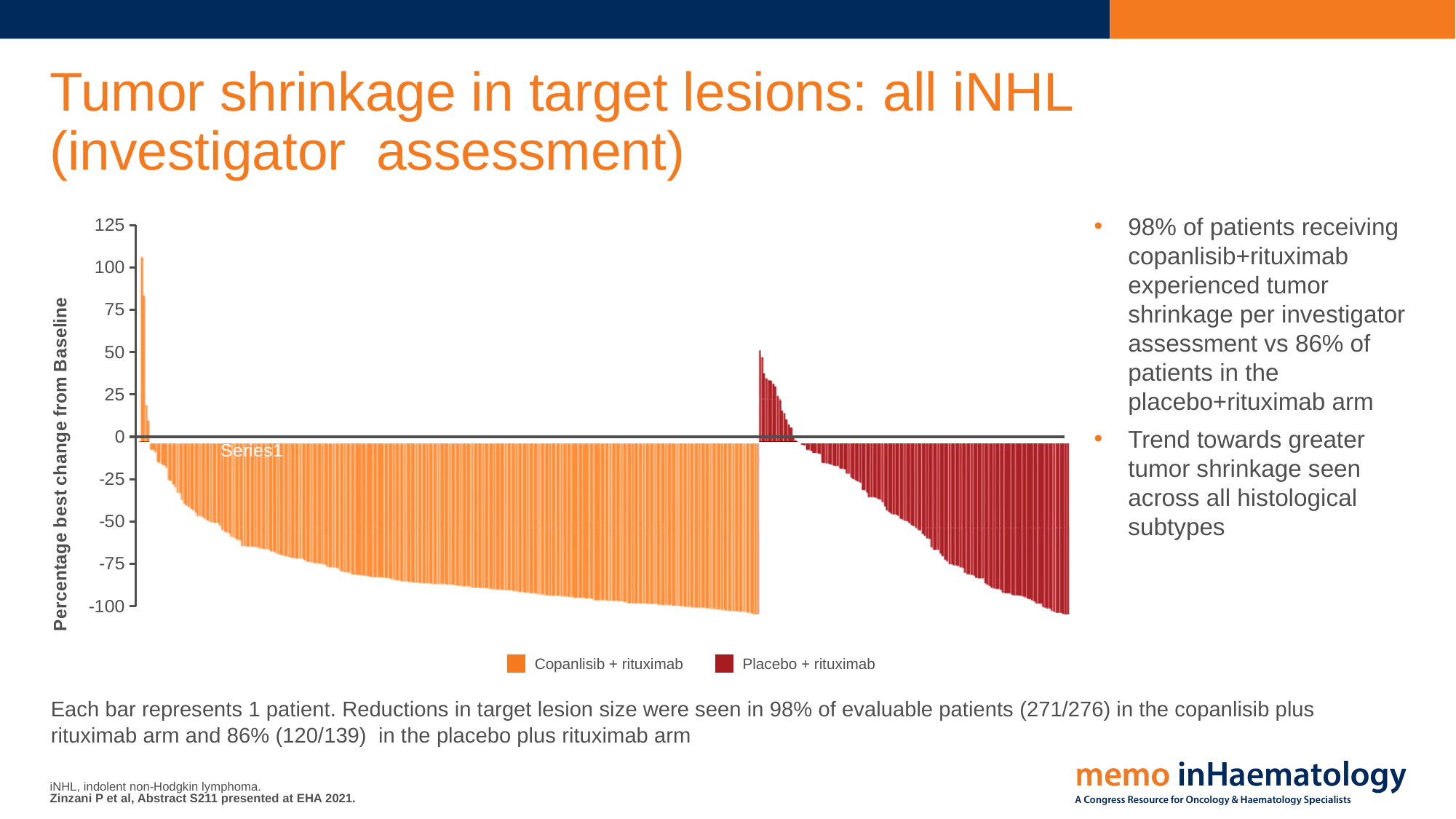
Is the tallest positive bar in the Copanlisib + rituximab series greater or less than 75? greater What is the highest tick value shown on the vertical axis? 125 Which series has the taller maximum positive bar, Copanlisib + rituximab or Placebo + rituximab? Copanlisib + rituximab Is the tallest positive bar in the Placebo + rituximab series greater or less than 75? less What is the label of the vertical axis? Percentage best change from Baseline Within each series, do the bar values rise or fall from left to right along the x axis? fall What are the two series named in the legend? Copanlisib + rituximab; Placebo + rituximab How many series does the legend list? 2 What is the lowest tick value shown on the vertical axis? -100 What kind of chart is shown on the slide? bar chart Is the tallest positive bar in the Placebo + rituximab series greater or less than 25? greater Which colour represents the Placebo + rituximab series? dark red